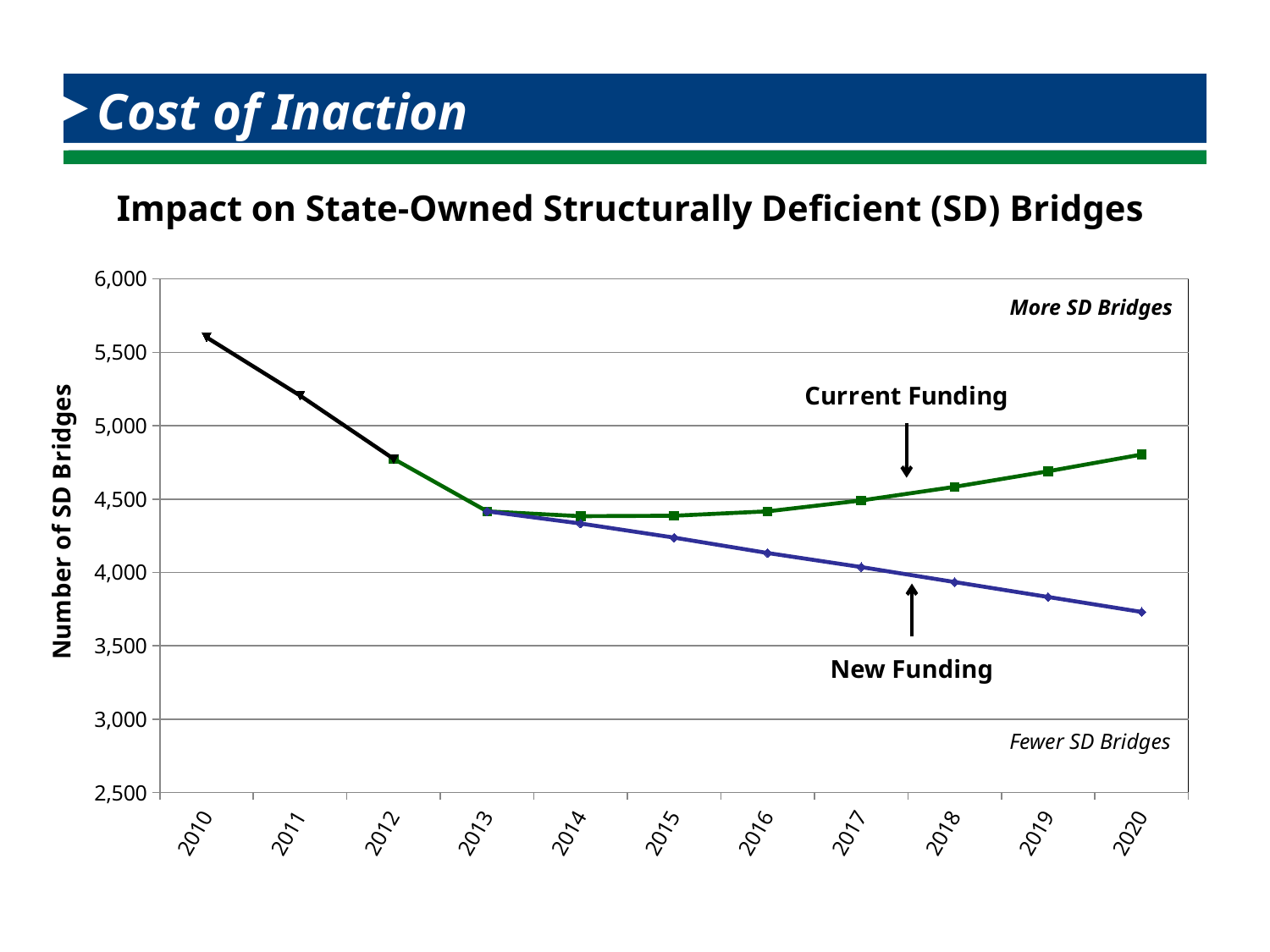
What kind of chart is shown on the slide? line chart Is the Current Funding value for 2016 greater or less than 4,500? less Is the number of SD bridges in 2010 greater or less than 5,500? greater Does the New Funding line rise or fall from 2013 to 2020? fall Does the Current Funding line rise or fall from 2015 to 2020? rise In 2020, which line is higher, Current Funding or New Funding? Current Funding What is the title of the chart? Impact on State-Owned Structurally Deficient (SD) Bridges Is the Current Funding value for 2020 greater or less than 4,500? greater How many years are shown on the x axis of the chart? 11 What is the label on the vertical axis of the chart? Number of SD Bridges